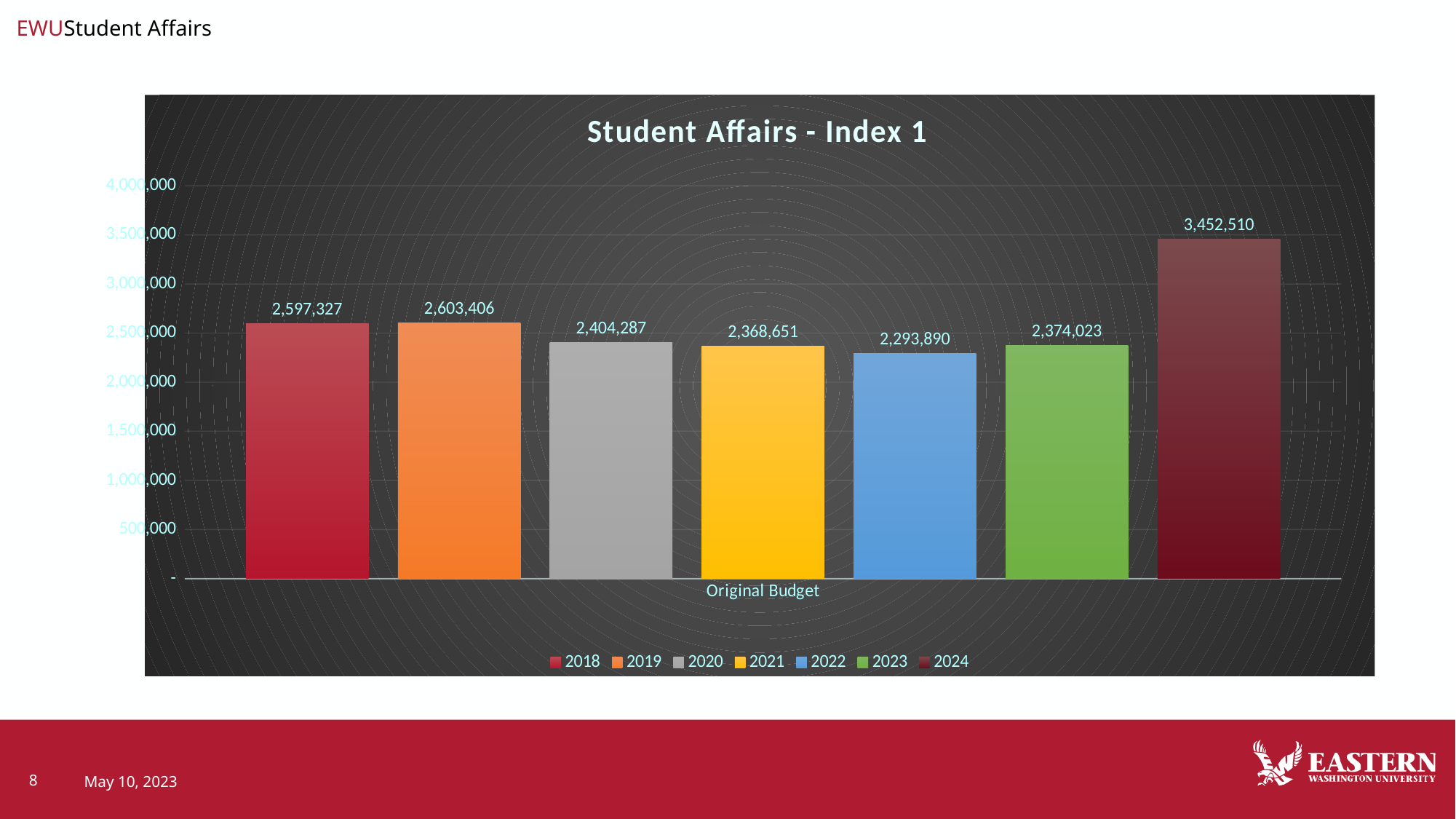
What is the difference between the 2024 and 2018 Original Budget values? 855,183 What is the Original Budget value for 2022? 2,293,890 Which is larger, the Original Budget for 2021 or for 2023? 2023 Is the Original Budget value for 2024 greater or less than 3,000,000? greater Which year has the highest Original Budget? 2024 How many series does the legend list? 7 Which year has the lowest Original Budget? 2022 What is the title of the chart? Student Affairs - Index 1 What is the difference between the 2019 and 2018 Original Budget values? 6,079 What is the Original Budget value for 2020? 2,404,287 What kind of chart is shown on the slide? bar chart What is the Original Budget value for 2024? 3,452,510